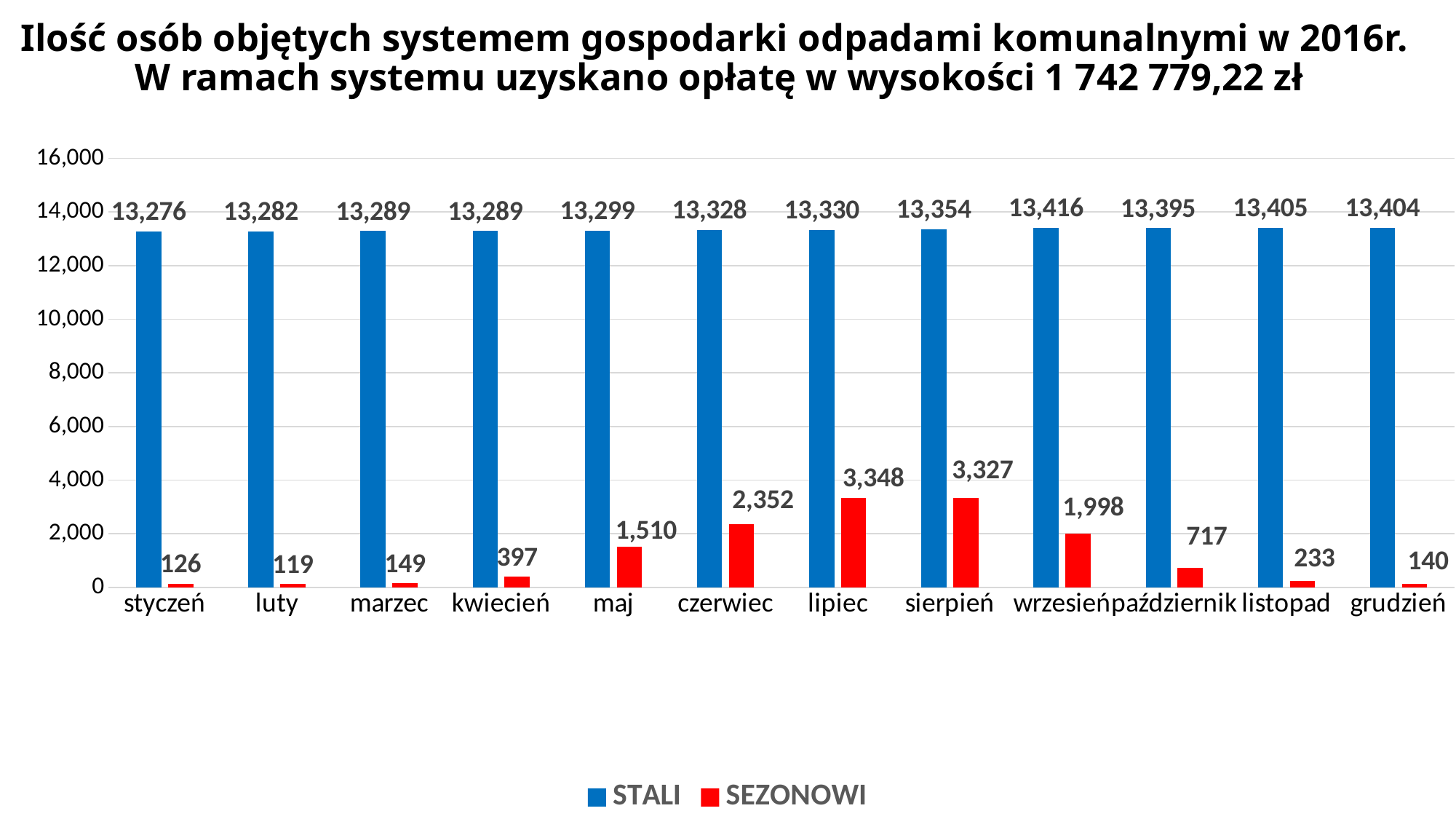
How many series does the legend list? 2 How many months are shown on the x axis? 12 What is the difference between the SEZONOWI values for lipiec and sierpień? 21 Which month has the lowest SEZONOWI value? luty Which month has the highest STALI value? wrzesień Which is larger, the SEZONOWI value for maj or for wrzesień? wrzesień Which month has the highest SEZONOWI value? lipiec What is the STALI value for wrzesień? 13,416 What is the difference between the STALI values for wrzesień and styczeń? 140 What kind of chart is shown on the slide? bar chart What is the SEZONOWI value for październik? 717 What is the SEZONOWI value for czerwiec? 2,352